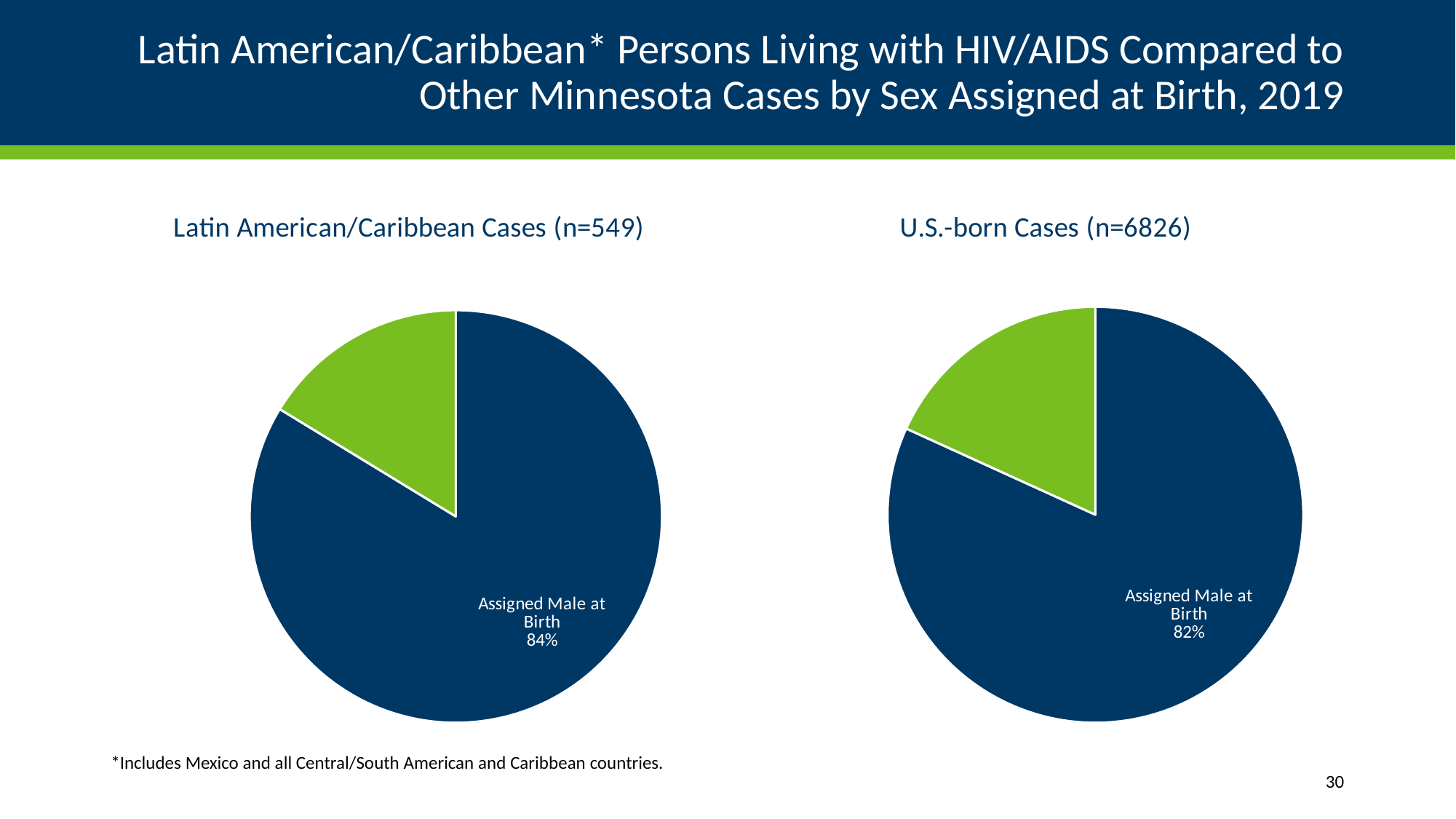
In the Latin American/Caribbean Cases chart, what share of cases is labelled Assigned Male at Birth? 84% In the U.S.-born Cases chart, is the Assigned Male at Birth share greater or less than 50%? greater How many slices does the U.S.-born Cases pie chart have? 2 In the Latin American/Caribbean Cases chart, which slice is the largest? Assigned Male at Birth In the U.S.-born Cases chart, what share of cases is labelled Assigned Male at Birth? 82% What is the sample size (n) shown in the title of the U.S.-born Cases chart? 6826 What kind of chart is used for the Latin American/Caribbean Cases? Pie chart Which chart shows a larger share for Assigned Male at Birth, Latin American/Caribbean Cases or U.S.-born Cases? Latin American/Caribbean Cases What is the difference in percentage points between the Assigned Male at Birth share in the Latin American/Caribbean Cases chart and in the U.S.-born Cases chart? 2 percentage points What is the sample size (n) shown in the title of the Latin American/Caribbean Cases chart? 549